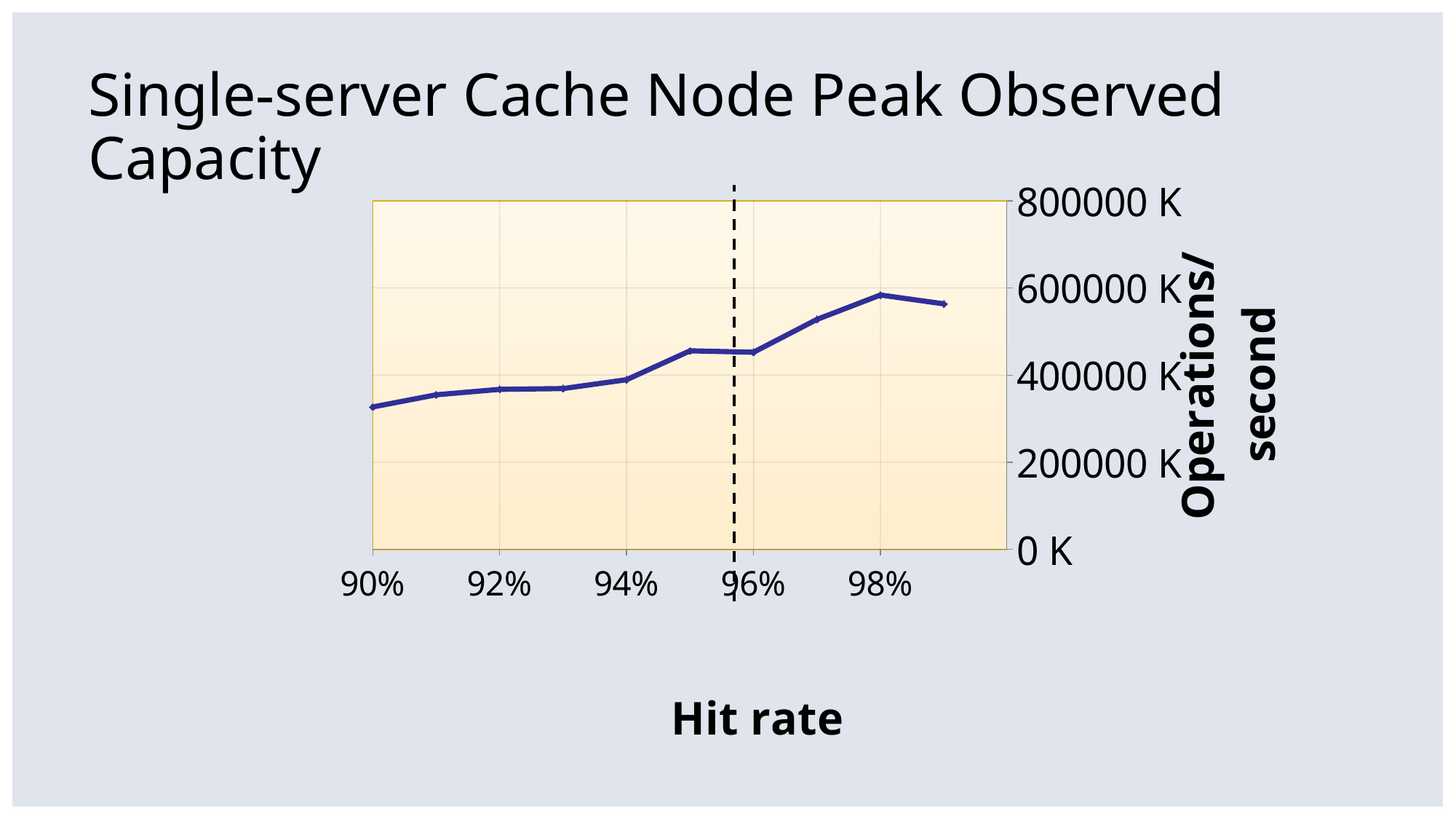
At which hit rate is the operations/second value lowest? 90% Which has the larger operations/second value, a 92% hit rate or a 97% hit rate? 97% What is the title of the chart? Single-server Cache Node Peak Observed Capacity Is the value at a 90% hit rate greater or less than 400000 K? less At which hit rate is the operations/second value highest? 98% Is the value at a 98% hit rate greater or less than 400000 K? greater How many data points are plotted on the line? 10 What kind of chart is shown on the slide? line chart Is the value at a 98% hit rate greater or less than 600000 K? less Do the operations/second values generally rise or fall as the hit rate increases from 90% to 98%? rise What is the label of the x axis? Hit rate